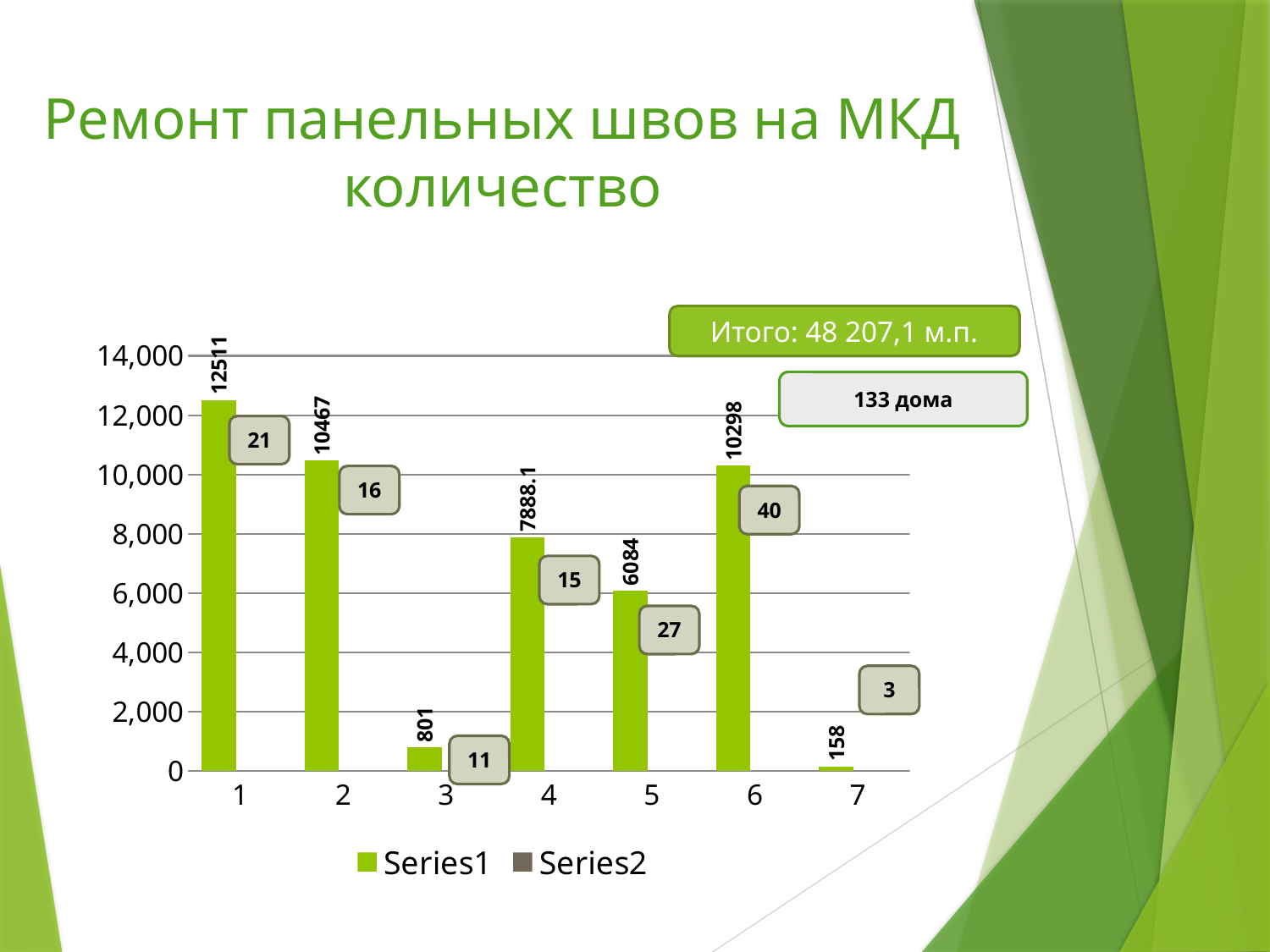
What is the difference between the Series1 values for category 1 and category 2? 2044 What total is shown in the green box above the chart? Итого: 48 207,1 м.п. What is the value for category 7 in Series1? 158 How many categories are shown on the x axis? 7 Which is larger, the Series1 value for category 2 or for category 6? category 2 What kind of chart is shown on the slide? bar chart What is the value for category 1 in Series1? 12511 How many series does the legend list? 2 Is the value for category 5 greater or less than 6,000? greater Which category has the highest Series1 value? 1 Which category has the lowest Series1 value? 7 What is the value for category 4 in Series1? 7888.1